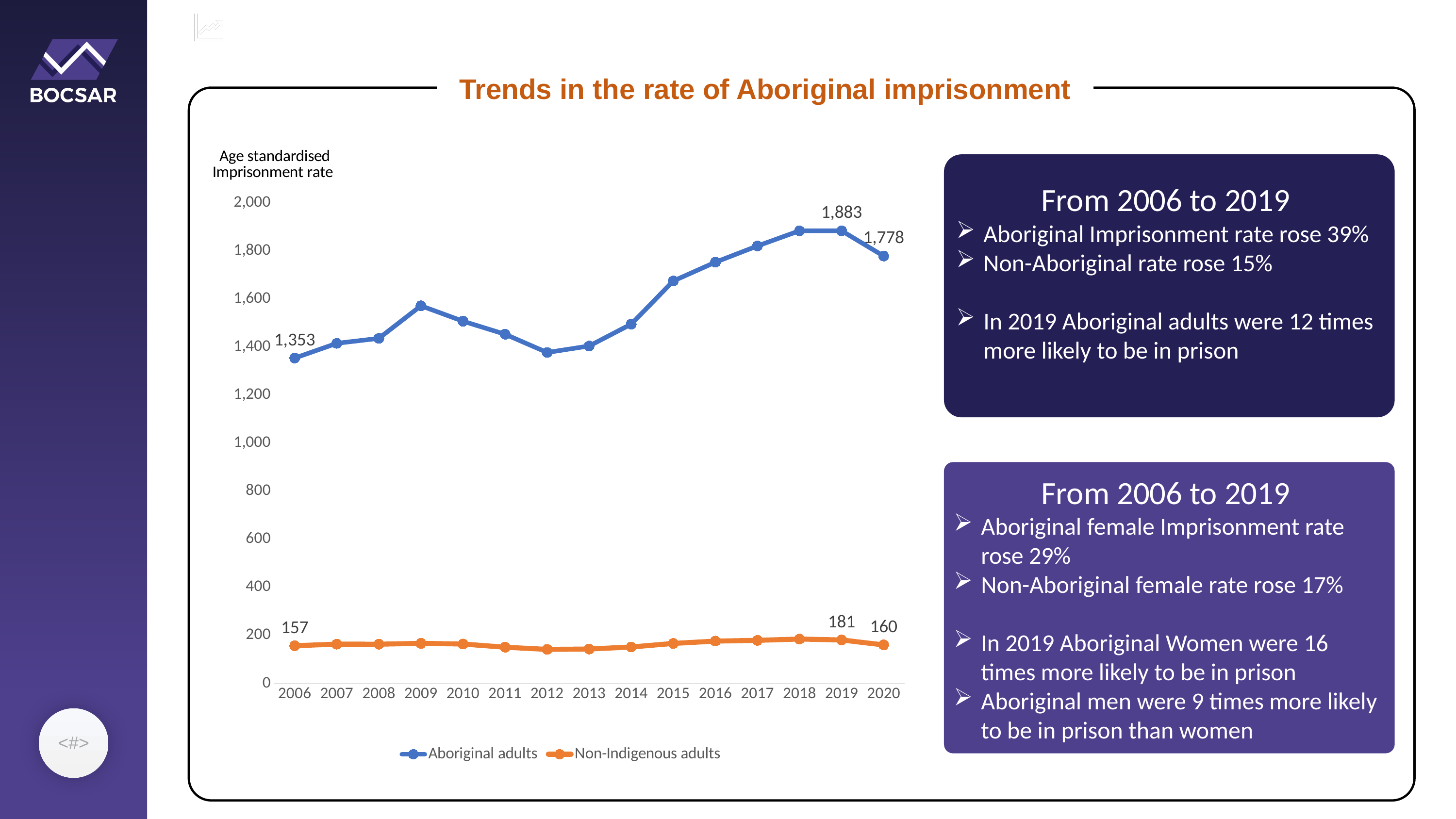
What is the age standardised imprisonment rate for Aboriginal adults in 2006? 1,353 What type of chart is used to show the trends in the rate of Aboriginal imprisonment? Line chart Which year has the higher Aboriginal adults imprisonment rate, 2006 or 2020? 2020 By how much did the Aboriginal adults imprisonment rate increase from 2006 (1,353) to 2019 (1,883)? 530 How many series does the chart legend list? 2 What is the age standardised imprisonment rate for Aboriginal adults in 2020? 1,778 What is the imprisonment rate for Non-Indigenous adults in 2019? 181 What is the difference between the Non-Indigenous adults rate in 2019 and in 2020? 21 What is the imprisonment rate for Non-Indigenous adults in 2020? 160 Is the Aboriginal adults imprisonment rate in 2012 greater or less than 1,400? less How many years are shown on the x axis of the chart? 15 What is the imprisonment rate for Non-Indigenous adults in 2006? 157